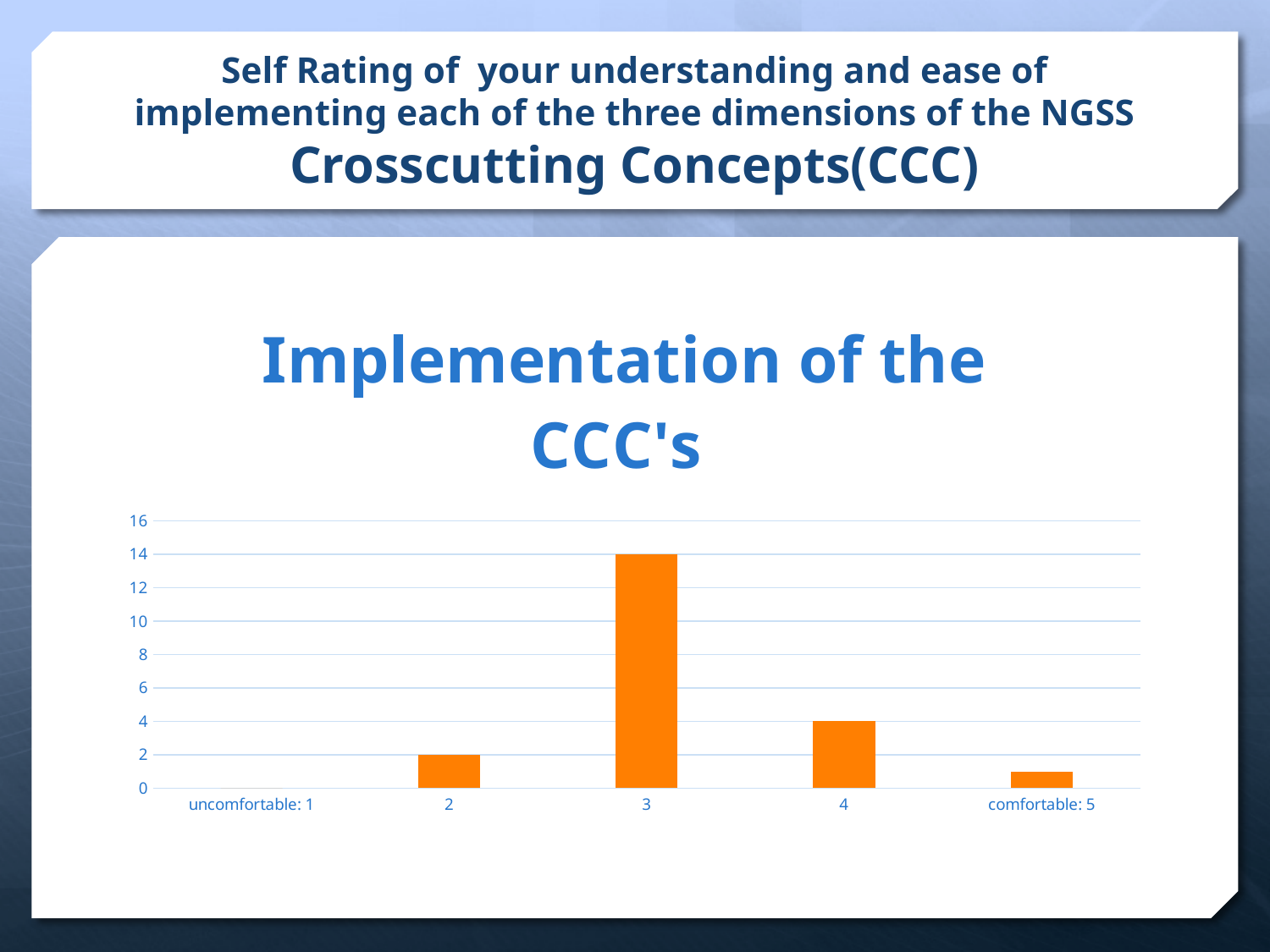
What is the difference between the values for category 3 and category 4? 10 What is the value for category 2? 2 What type of chart is shown on the slide? bar chart Is the value for category 3 greater or less than 10? greater Which category has the highest bar? 3 How many categories are shown on the x axis of the chart? 5 What is the difference between the values for category 3 and category 2? 12 What is the value for category 3? 14 Is the value for 'comfortable: 5' greater or less than 2? less Which is larger, the value for category 4 or the value for category 2? 4 What is the title of the chart? Implementation of the CCC's What is the value for category 4? 4